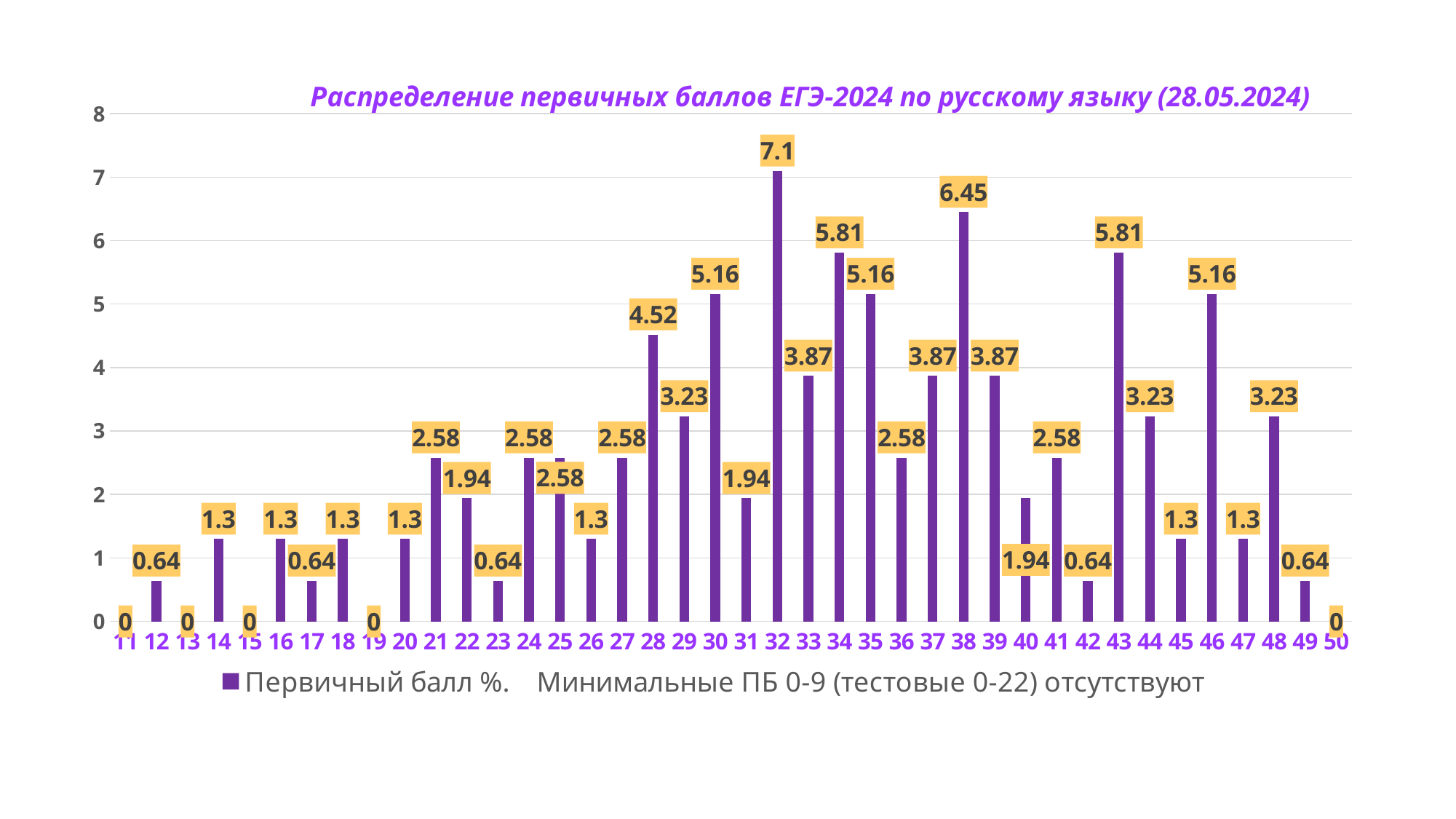
What kind of chart is shown on the slide? bar chart What is the difference between the values for primary scores 32 and 38? 0.65 How many primary score categories are shown on the x axis? 40 Which is larger, the value for primary score 28 or for primary score 29? 28 What is the value for primary score 50? 0 Which primary score has the highest value? 32 What is the value for primary score 28? 4.52 What is the difference between the values for primary scores 30 and 29? 1.93 What is the title of the chart? Распределение первичных баллов ЕГЭ-2024 по русскому языку (28.05.2024) Is the value for primary score 32 greater or less than 7? greater What is the value for primary score 38? 6.45 What is the value for primary score 32? 7.1